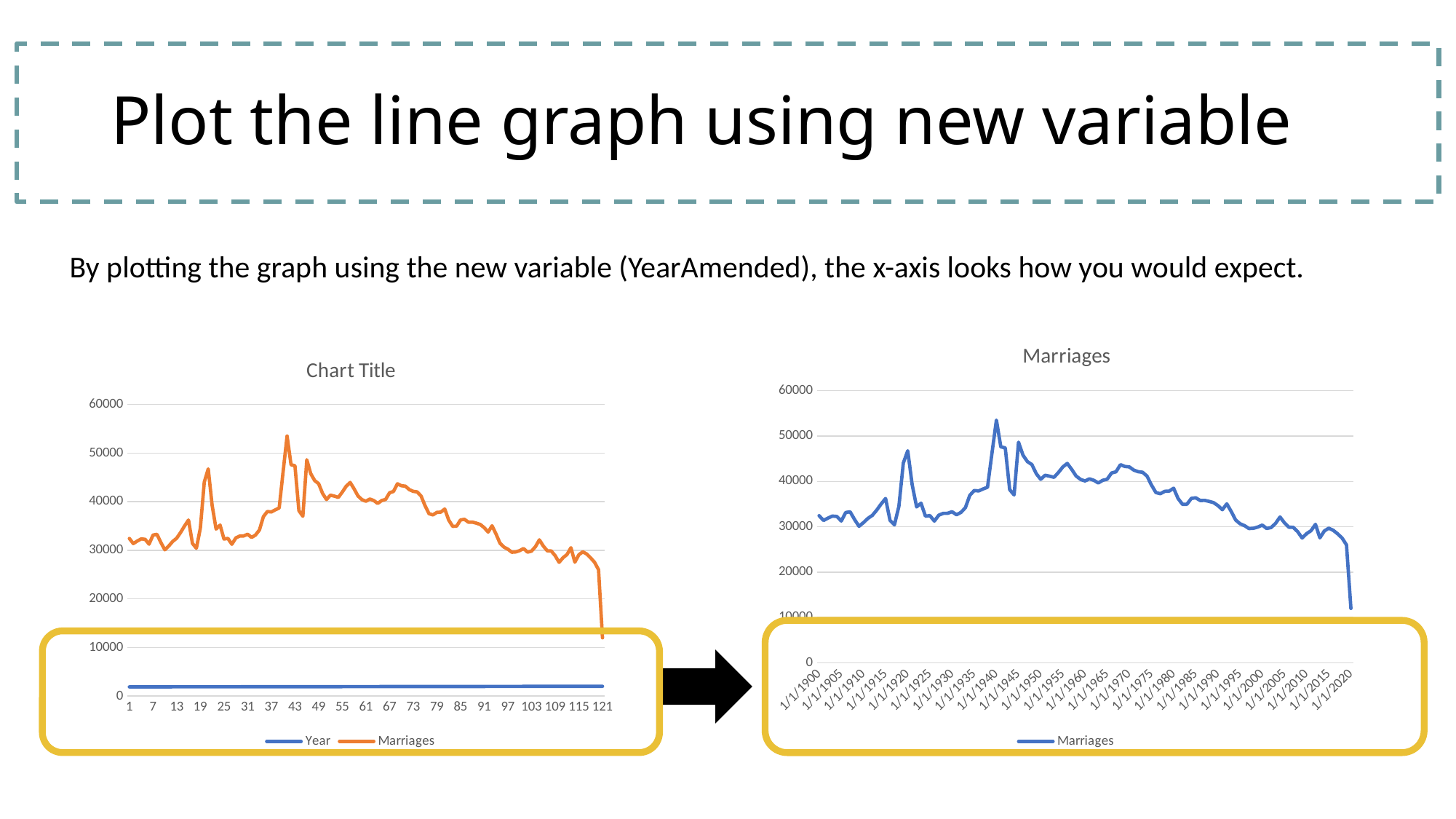
How many series does the legend of the right chart ('Marriages') list? 1 In the right chart ('Marriages'), is the highest value of the Marriages series greater or less than 50000? greater What are the legend entries of the left chart ('Chart Title')? Year, Marriages What is the last x-axis tick label on the left chart ('Chart Title')? 121 In the right chart ('Marriages'), is the value at 1/1/2020 greater or less than 20000? less In the right chart ('Marriages'), do the values rise or fall between 1/1/1975 and 1/1/2020? fall What kind of chart is the chart on the right titled 'Marriages'? line chart What is the title of the chart on the right? Marriages What is the last x-axis tick label on the right chart ('Marriages')? 1/1/2020 In the left chart ('Chart Title'), which series has higher values, Year or Marriages? Marriages How many series does the legend of the left chart ('Chart Title') list? 2 In the left chart ('Chart Title'), is the value of the Year series greater or less than 10000? less